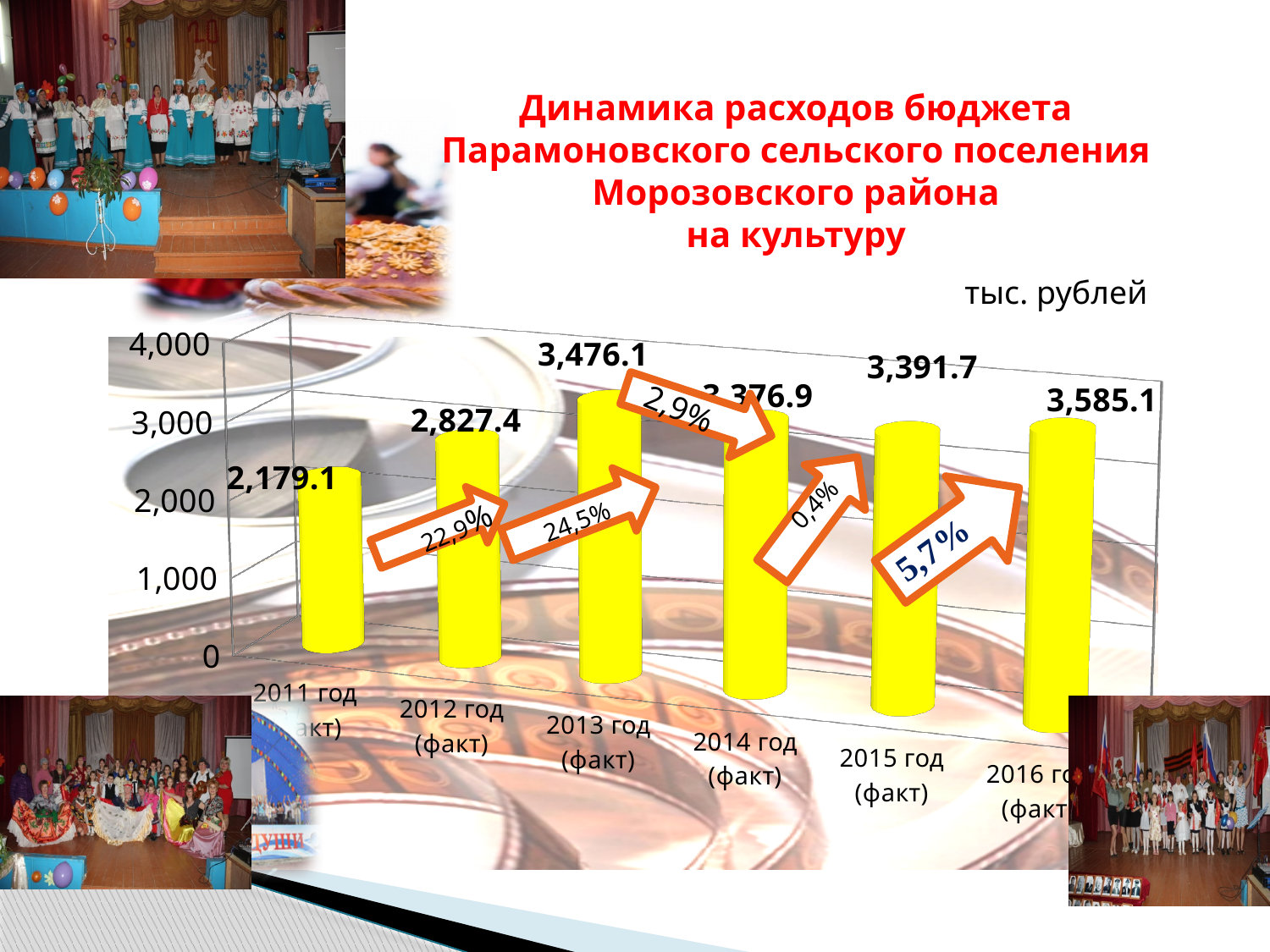
Which year has the lowest value? 2011 год (факт) What is the value for 2016 год (факт)? 3,585.1 What is the value for 2011 год (факт)? 2,179.1 What kind of chart is shown on the slide? bar chart Which is larger, the value for 2013 год (факт) or 2015 год (факт)? 2013 год (факт) What is the difference between the values for 2016 год (факт) and 2015 год (факт)? 193.4 What is the difference between the values for 2012 год (факт) and 2011 год (факт)? 648.3 Is the value for 2014 год (факт) greater or less than 3,000? greater Which year has the highest value? 2016 год (факт) What is the value for 2015 год (факт)? 3,391.7 What is the value for 2013 год (факт)? 3,476.1 How many years are shown on the chart? 6